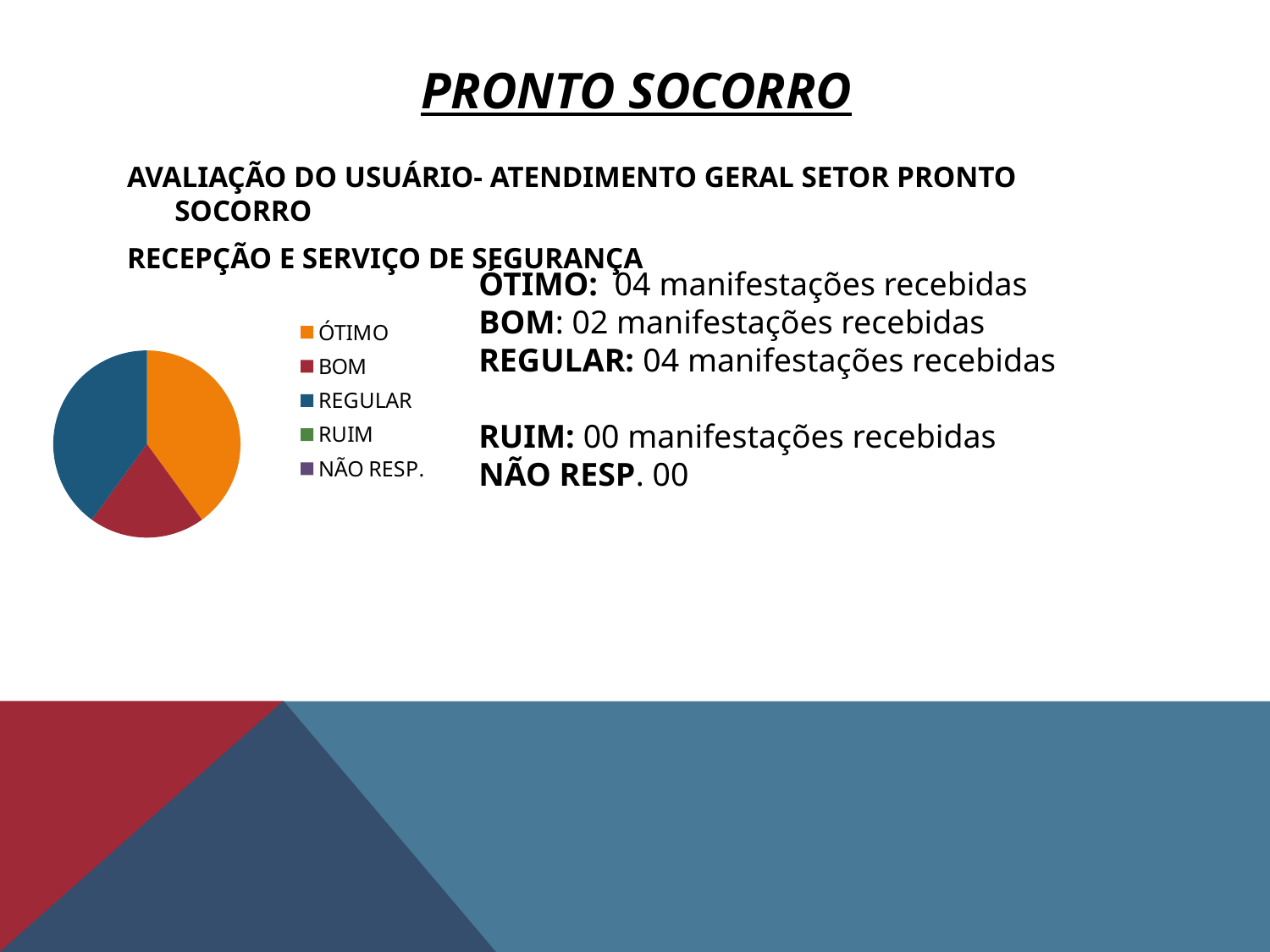
What share of the pie does the BOM slice represent? 20% What is the difference between the values for ÓTIMO and BOM? 2 What kind of chart is shown on the slide? pie chart How many categories does the pie chart's legend list? 5 How many manifestações recebidas are reported for ÓTIMO? 04 How many manifestações recebidas are reported for RUIM? 00 How many manifestações recebidas are reported for BOM? 02 How many manifestações recebidas are reported for REGULAR? 04 What share of the pie does the ÓTIMO slice represent? 40% Which is larger, the value for ÓTIMO or the value for BOM? ÓTIMO Which is larger, the value for REGULAR or the value for BOM? REGULAR Which colour represents REGULAR in the pie chart? blue